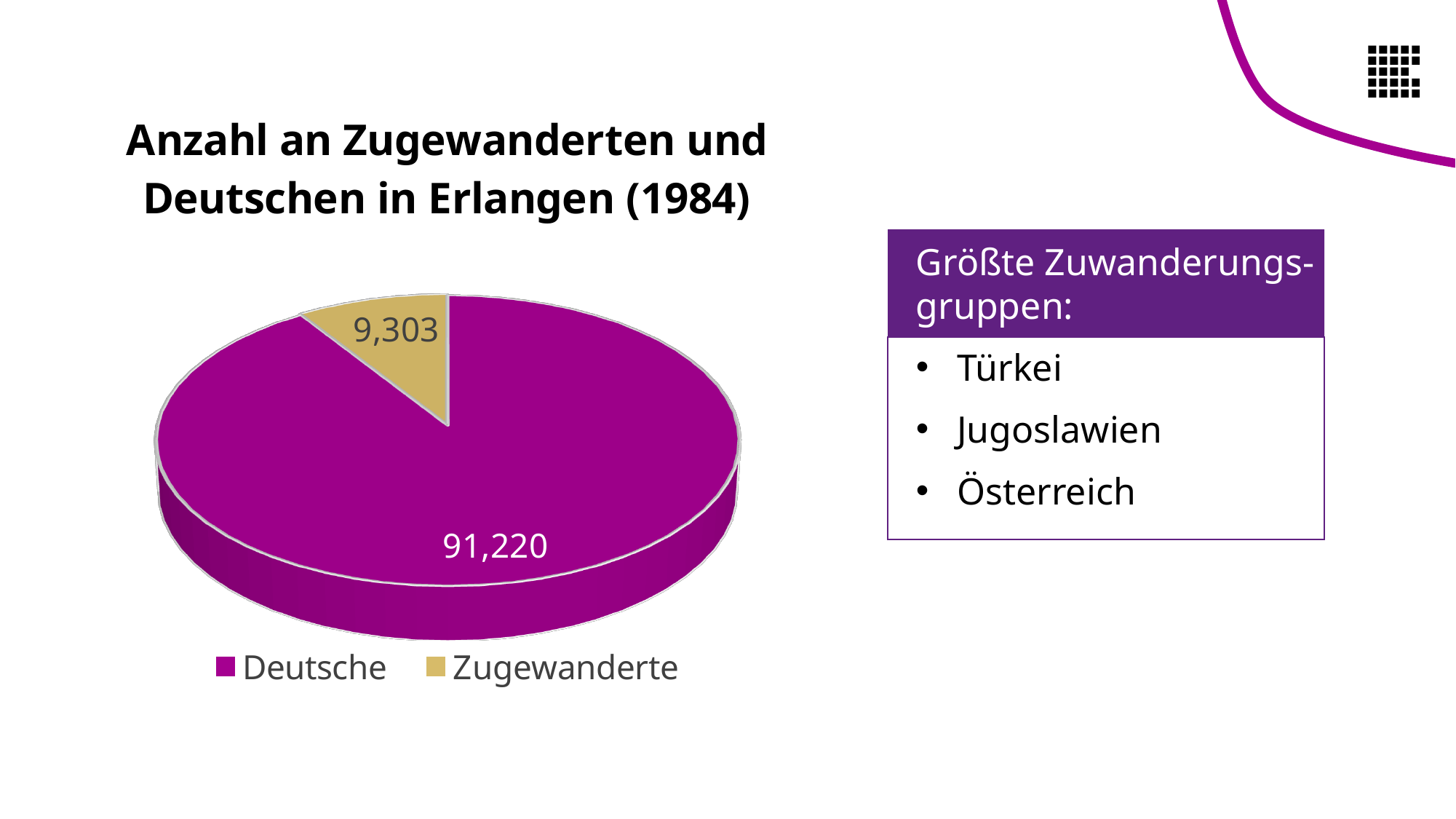
Which colour represents Zugewanderte in the pie chart? Gold (tan) Which is larger, the value for Deutsche or the value for Zugewanderte? Deutsche What is the value for Zugewanderte in the pie chart? 9,303 What is the title of the chart? Anzahl an Zugewanderten und Deutschen in Erlangen (1984) What is the value for Deutsche in the pie chart? 91,220 What is the total of the two values shown in the pie chart? 100,523 What is the difference between the values for Deutsche and Zugewanderte? 81,917 How many entries does the legend list? 2 Which category has the largest slice in the pie chart? Deutsche How many slices does the pie chart have? 2 Which category has the smallest slice in the pie chart? Zugewanderte What kind of chart is shown on the slide? Pie chart